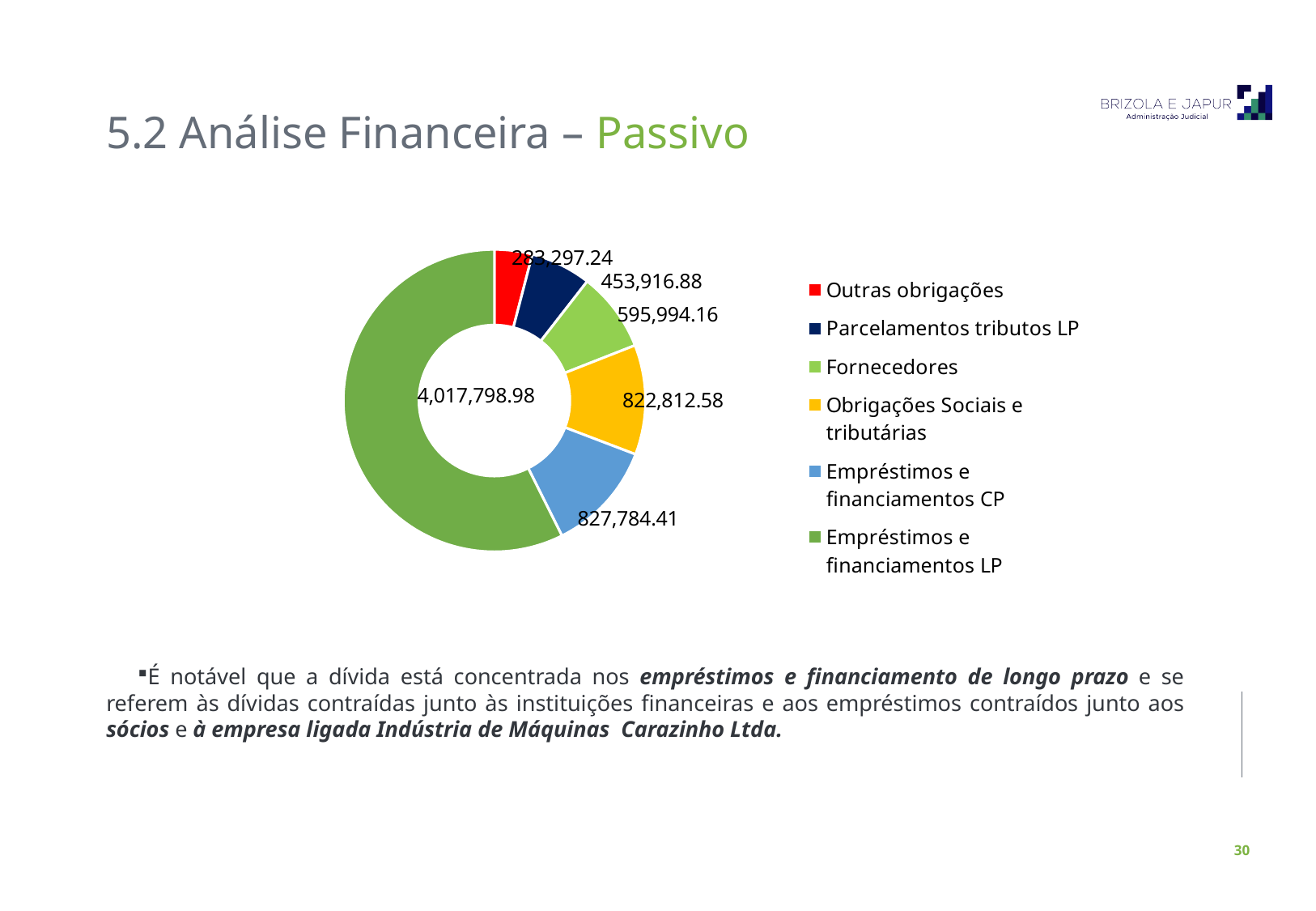
Which colour represents Fornecedores in the chart? Light green What is the value for Parcelamentos tributos LP? 453,916.88 What is the value for Empréstimos e financiamentos LP? 4,017,798.98 What is the difference between Fornecedores and Parcelamentos tributos LP? 142,077.28 What is the value for Empréstimos e financiamentos CP? 827,784.41 How many entries does the legend list? 6 Which category has the smallest value? Outras obrigações What is the value for Fornecedores? 595,994.16 How many categories does the chart show? 6 What type of chart is shown on the slide? Doughnut (pie) chart Which category has the largest value? Empréstimos e financiamentos LP What is the value for Obrigações Sociais e tributárias? 822,812.58